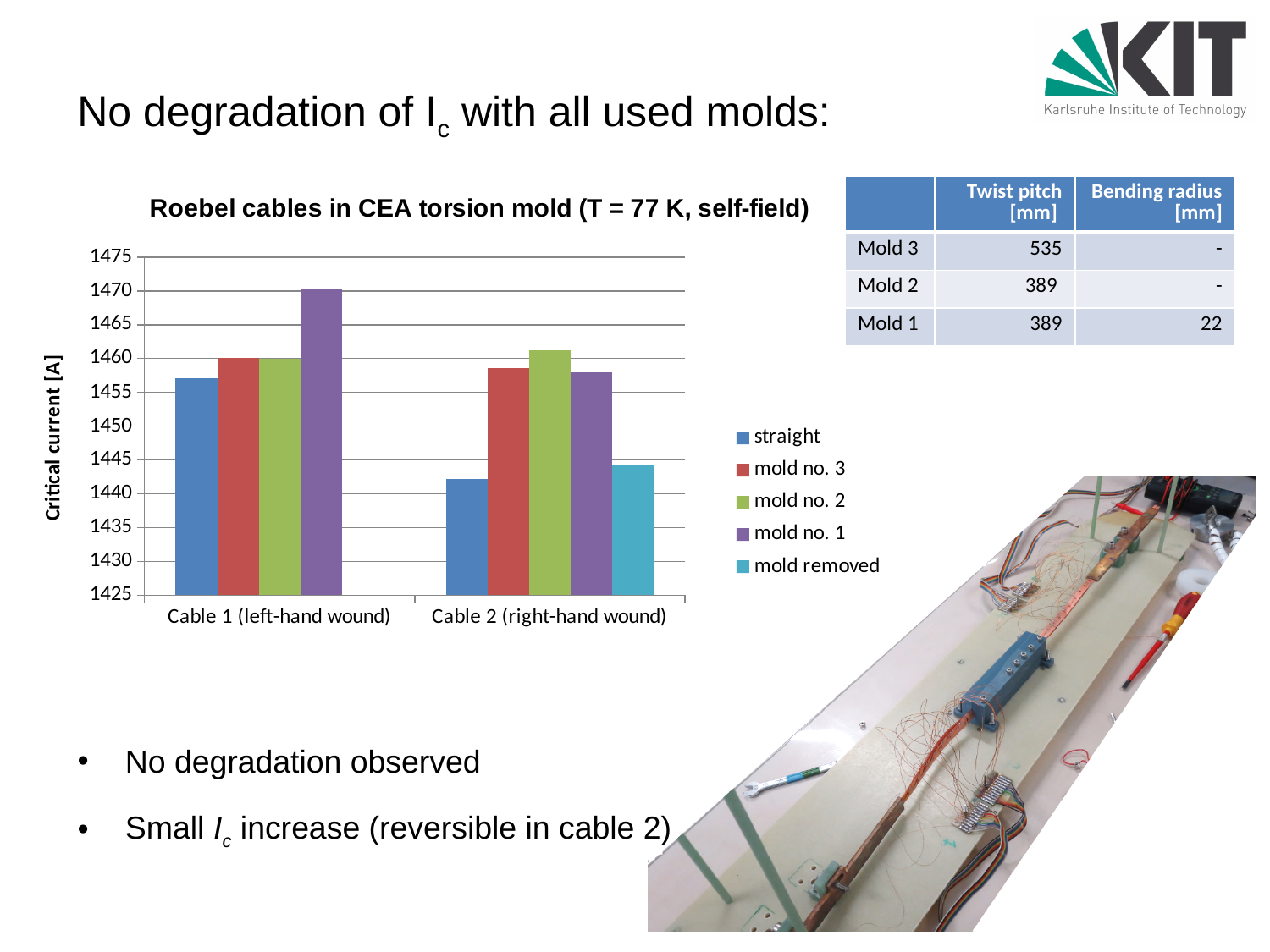
Is the critical current for mold removed on Cable 2 (right-hand wound) greater or less than 1450? less What is the title of the chart? Roebel cables in CEA torsion mold (T = 77 K, self-field) How many series does the chart legend list? 5 Is the critical current for straight on Cable 2 (right-hand wound) greater or less than 1445? less Is the critical current for mold no. 1 on Cable 1 (left-hand wound) greater or less than 1465? greater Which has the larger critical current for the straight series: Cable 1 (left-hand wound) or Cable 2 (right-hand wound)? Cable 1 (left-hand wound) How many cable categories are shown on the x axis of the chart? 2 Which series has the highest critical current for Cable 1 (left-hand wound)? mold no. 1 Which bar in the whole chart shows the lowest critical current? straight, Cable 2 (right-hand wound) What kind of chart is shown on the slide? bar chart Which has the larger critical current for mold no. 1: Cable 1 (left-hand wound) or Cable 2 (right-hand wound)? Cable 1 (left-hand wound) What is the label of the vertical axis of the chart? Critical current [A]